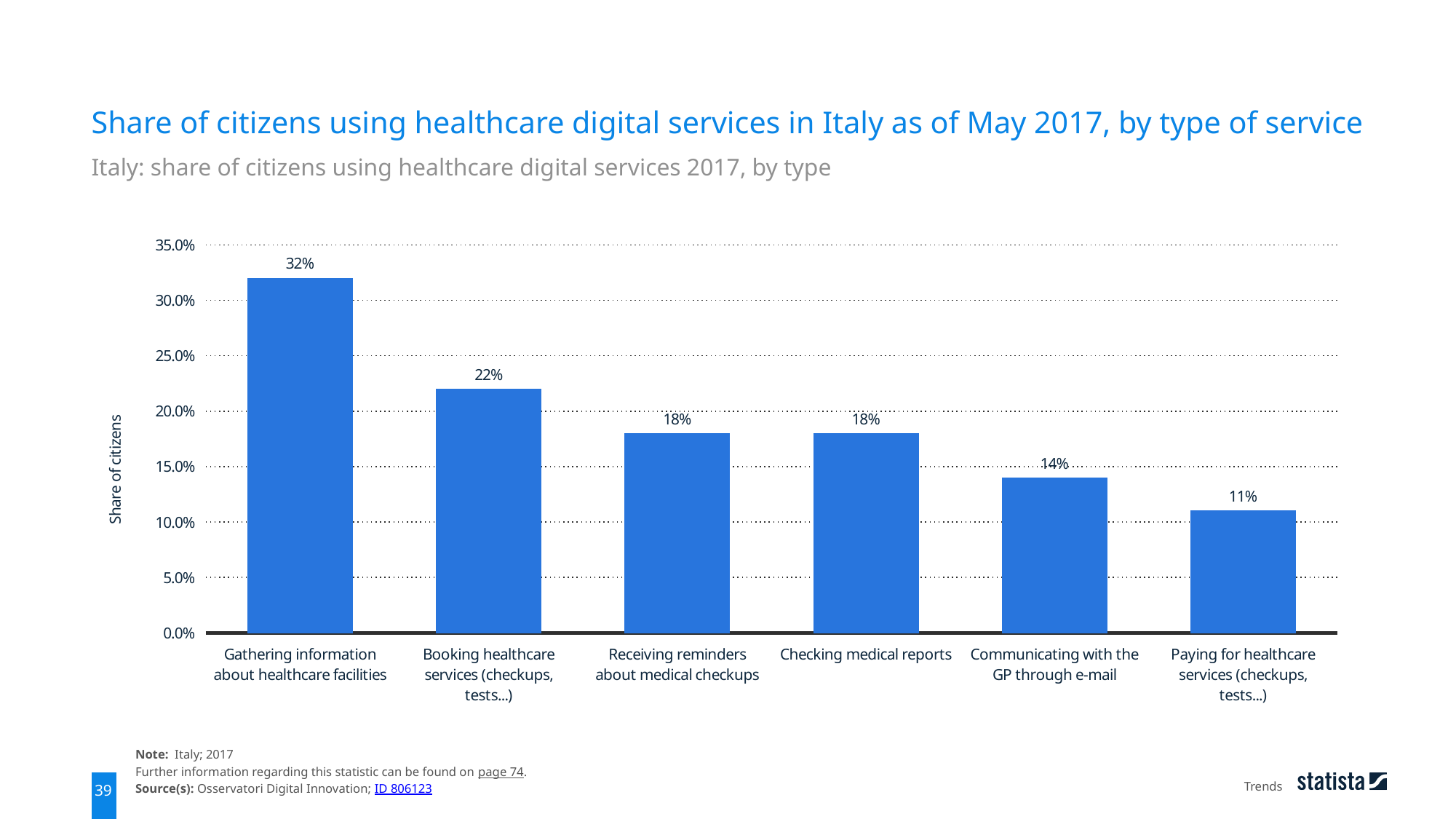
What is the share of citizens communicating with the GP through e-mail? 14% What is the share of citizens paying for healthcare services (checkups, tests...)? 11% Is the value for receiving reminders about medical checkups greater or less than 20.0%? less What kind of chart is shown on the slide? Bar chart Which type of service has the lowest share of citizens? Paying for healthcare services (checkups, tests...) What is the label of the y axis? Share of citizens How many types of service are shown in the chart? 6 What is the difference between the share for gathering information about healthcare facilities and the share for booking healthcare services? 10% Which type of service has the highest share of citizens? Gathering information about healthcare facilities What is the share of citizens booking healthcare services (checkups, tests...)? 22% What is the share of citizens gathering information about healthcare facilities? 32% Which is larger: the share for checking medical reports or the share for communicating with the GP through e-mail? Checking medical reports